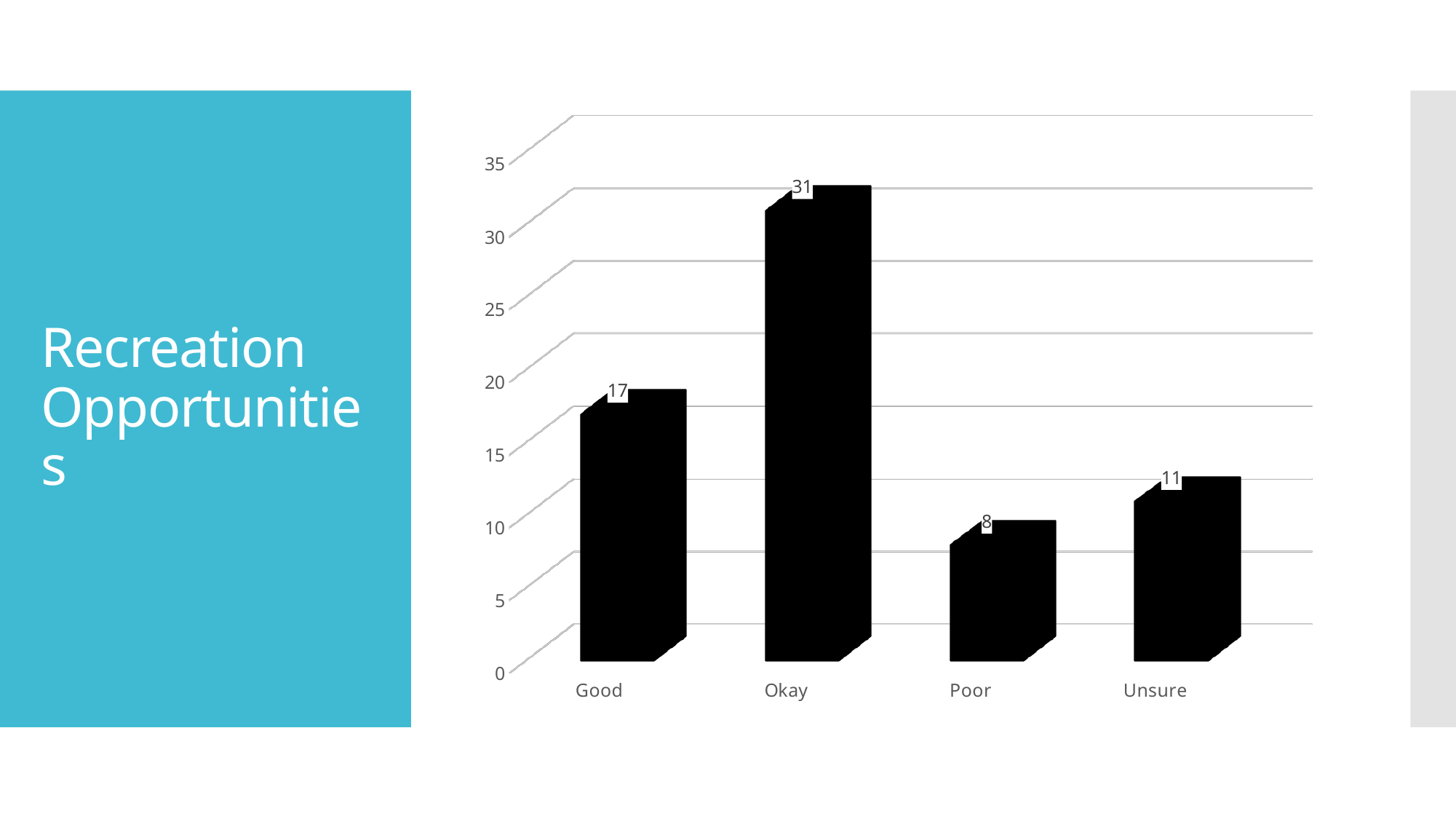
What is the difference between the values for Unsure and Poor? 3 What is the value for Good? 17 What is the difference between the values for Okay and Good? 14 Which is larger, the value for Good or the value for Unsure? Good Which category has the highest value? Okay Which category has the lowest value? Poor What is the value for Unsure? 11 What is the value for Poor? 8 How many categories are shown on the x axis? 4 What kind of chart is shown on the slide? bar chart Is the value for Okay greater or less than 25? greater What is the value for Okay? 31